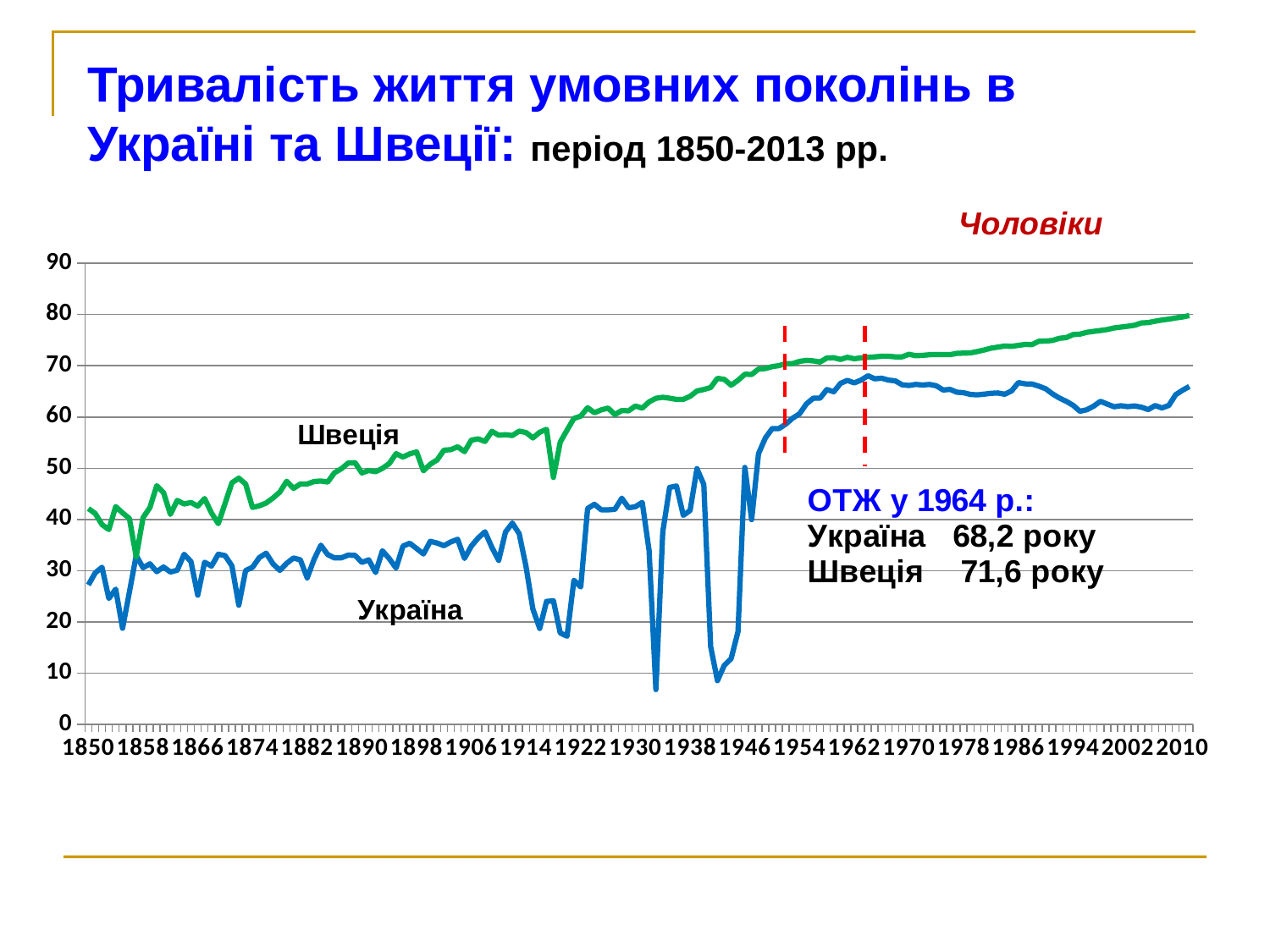
Which series lies higher on the chart across the whole period, Швеція or Україна? Швеція According to the annotation, what was the life expectancy (ОТЖ) of men in Sweden (Швеція) in 1964? 71,6 року How many countries (series) are plotted on the chart? 2 Which colour is used for the Україна line? blue By how many years did Sweden's male life expectancy exceed Ukraine's in 1964, based on the annotated values? 3,4 року According to the annotation, what was the life expectancy (ОТЖ) of men in Ukraine in 1964? 68,2 року Is the value for Україна in 2010 greater or less than 60? greater Is the lowest value for Україна in the 1930s greater or less than 10? less Does the Швеція line generally rise or fall from 1850 to 2013? rise Is the value for Швеція in 2010 greater or less than 70? greater In 1964, which country had the higher male life expectancy, Ukraine or Sweden? Швеція What kind of chart is shown on the slide? line chart